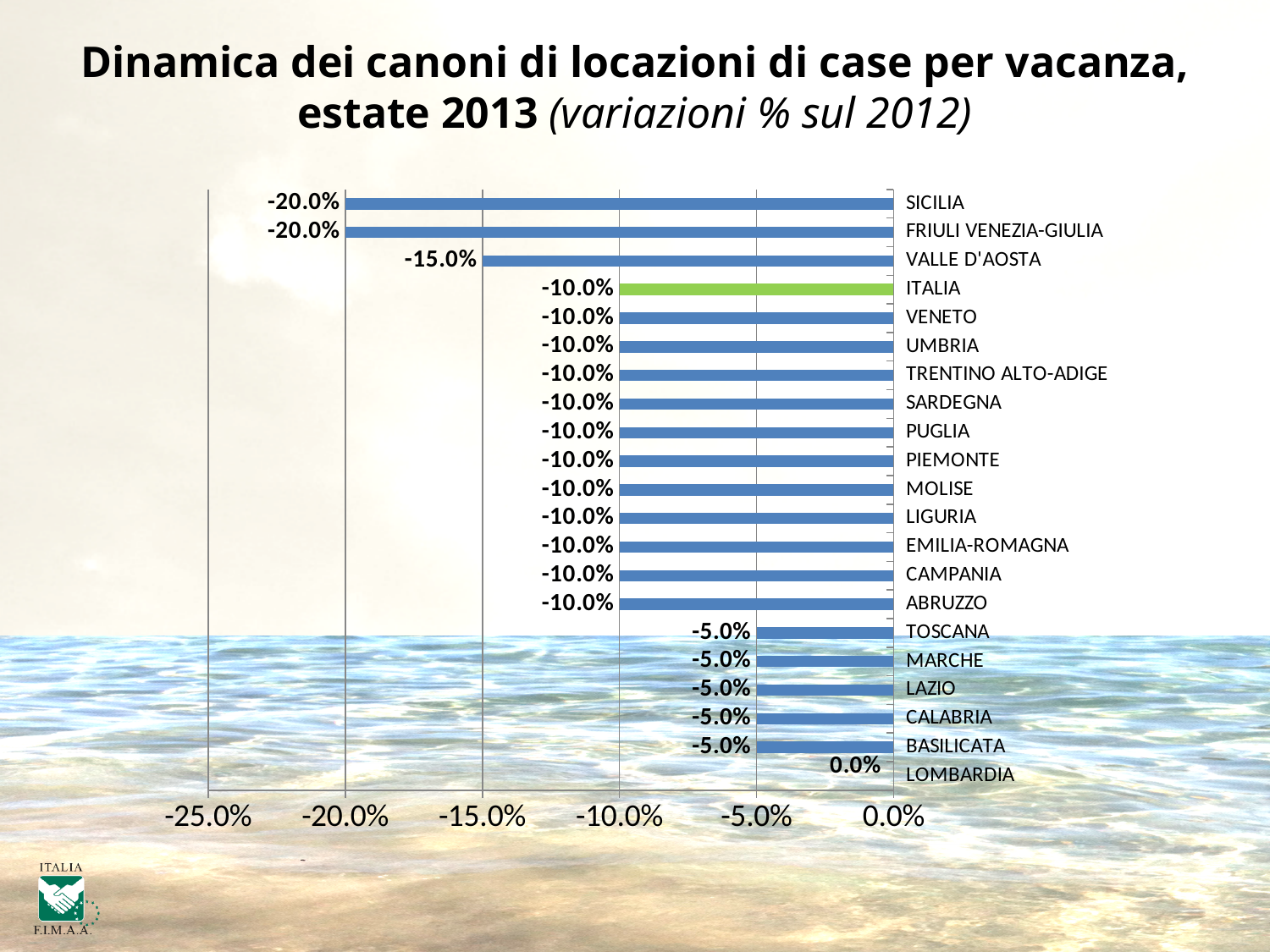
What is the difference between the values for VALLE D'AOSTA and ITALIA? 5.0 percentage points Which category has the highest value? LOMBARDIA Which has the larger value, MARCHE or ABRUZZO? MARCHE How many categories are shown in the chart? 21 What is the value for TOSCANA? -5.0% What is the value for VALLE D'AOSTA? -15.0% What is the difference between the values for SICILIA and BASILICATA? 15.0 percentage points What is the value for ITALIA? -10.0% What kind of chart is shown on the slide? Bar chart What is the value for LOMBARDIA? 0.0% Which category's bar is shown in green rather than blue? ITALIA What is the value for SICILIA? -20.0%